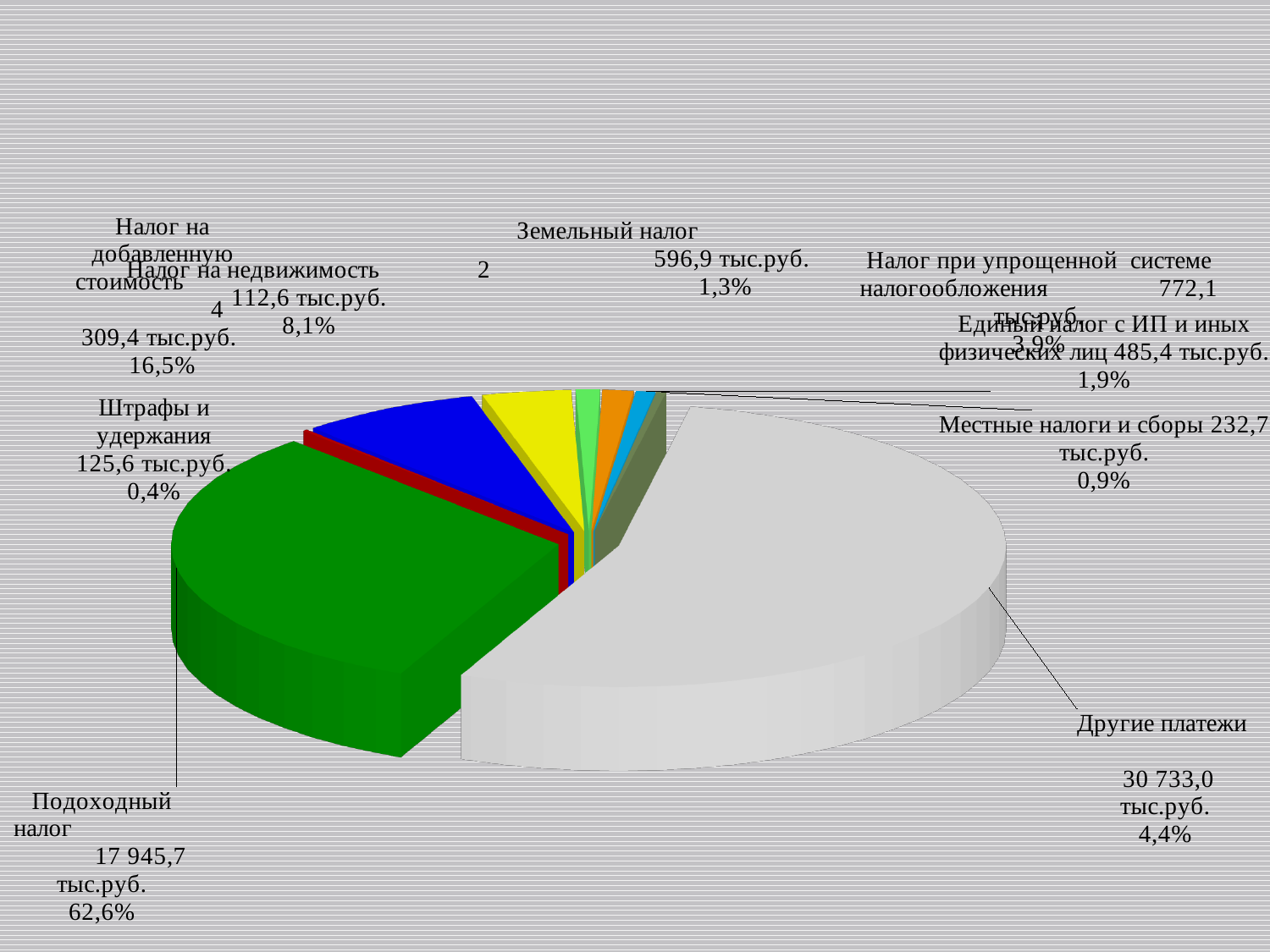
What is the difference between the amounts shown for Налог при упрощенной системе налогообложения and Земельный налог? 175,2 тыс.руб. How many categories (slices) does the pie chart show? 9 What amount is shown for Другие платежи? 30 733,0 тыс.руб. What kind of chart is shown on the slide? pie chart What amount is shown for Налог при упрощенной системе налогообложения? 772,1 тыс.руб. What amount is shown for Земельный налог? 596,9 тыс.руб. What amount is shown for Местные налоги и сборы? 232,7 тыс.руб. What percentage share is shown for Штрафы и удержания? 0,4% What percentage share is shown for Единый налог с ИП и иных физических лиц? 1,9% What percentage share is shown for Земельный налог? 1,3% What percentage share is shown for Подоходный налог? 62,6% Which has the larger percentage share shown, Земельный налог or Единый налог с ИП и иных физических лиц? Единый налог с ИП и иных физических лиц